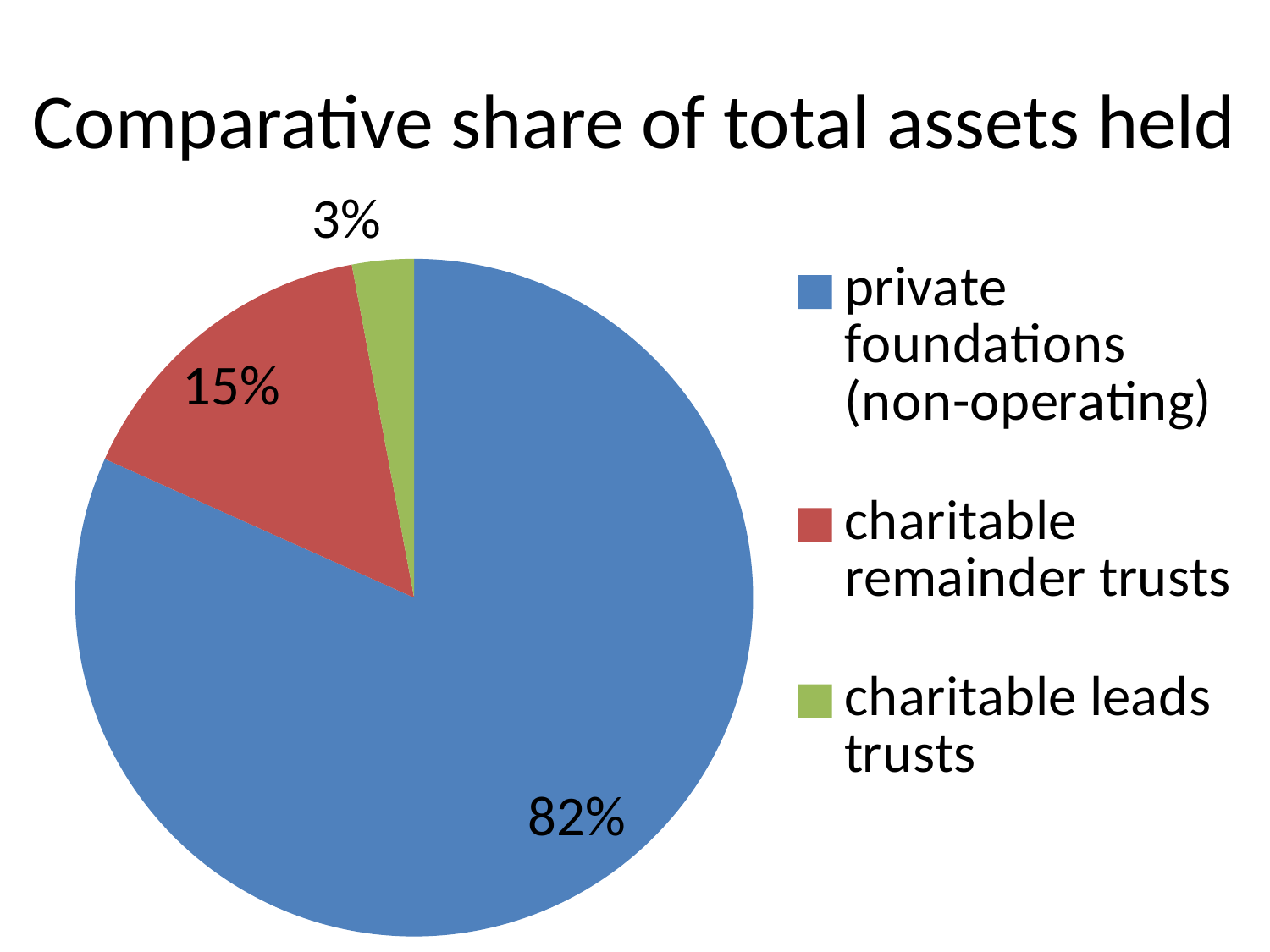
What colour is the slice for charitable leads trusts? green Which category holds the smallest share of total assets? charitable leads trusts What share of total assets is held by private foundations (non-operating)? 82% What is the title of the chart? Comparative share of total assets held What kind of chart is shown on the slide? pie chart How many percentage points larger is the share for private foundations (non-operating) than for charitable remainder trusts? 67 What share of total assets is held by charitable leads trusts? 3% Which holds a larger share of total assets, charitable remainder trusts or charitable leads trusts? charitable remainder trusts What share of total assets is held by charitable remainder trusts? 15% How many percentage points larger is the share for charitable remainder trusts than for charitable leads trusts? 12 How many slices does the pie chart have? 3 Which category holds the largest share of total assets? private foundations (non-operating)